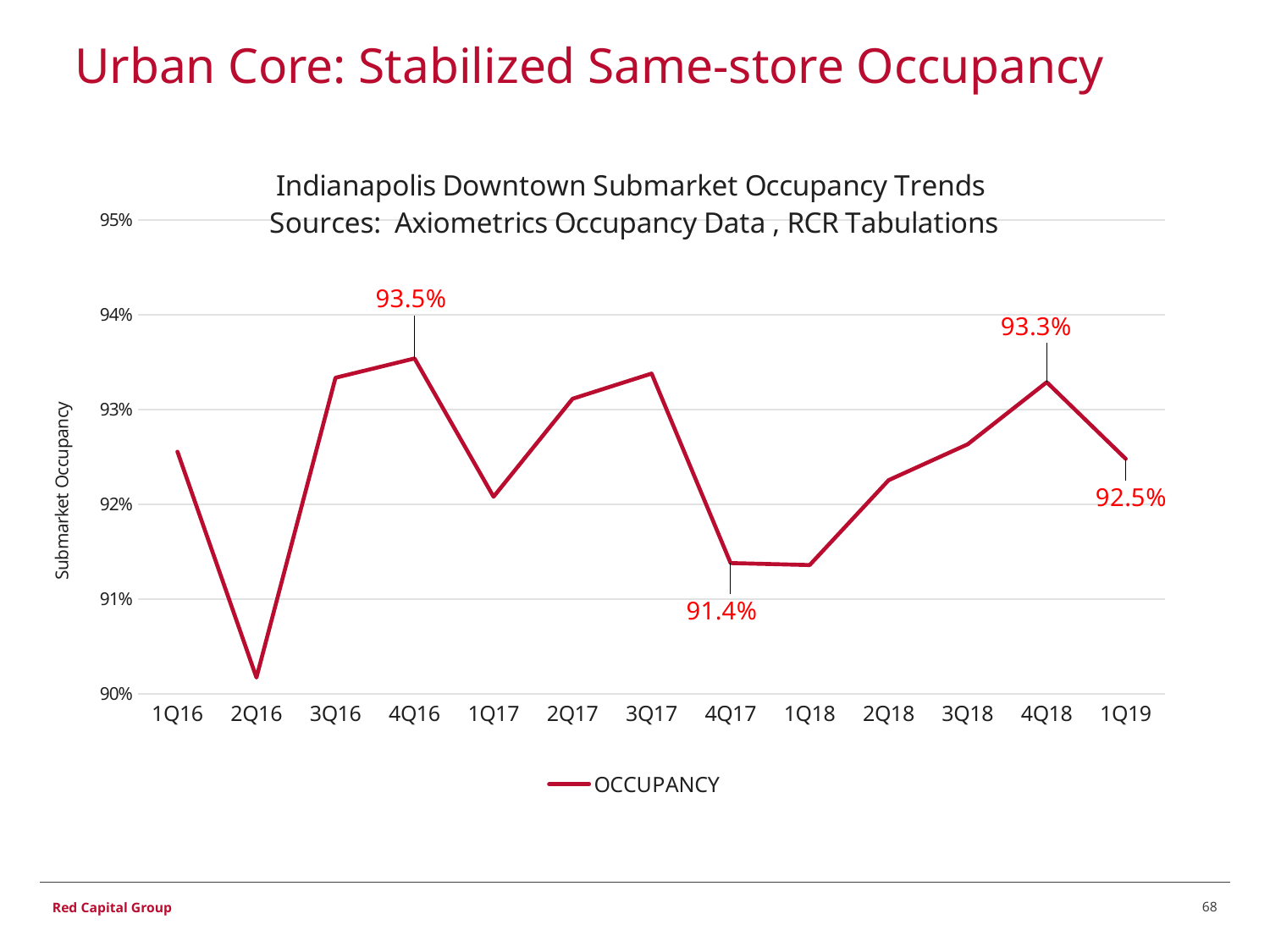
What is the occupancy value labeled for 1Q19? 92.5% Which is larger, the occupancy for 4Q18 or 1Q19? 4Q18 What is the occupancy value labeled for 4Q18? 93.3% How many quarters are shown on the x axis? 13 Is the occupancy for 2Q16 greater or less than 91%? less What type of chart is shown on the slide? line chart Which quarter has the highest occupancy on the chart? 4Q16 Which quarter has the lowest occupancy on the chart? 2Q16 What is the occupancy value labeled for 4Q16? 93.5% What is the difference between the labeled occupancy values for 4Q16 and 4Q17? 2.1% What is the occupancy value labeled for 4Q17? 91.4%